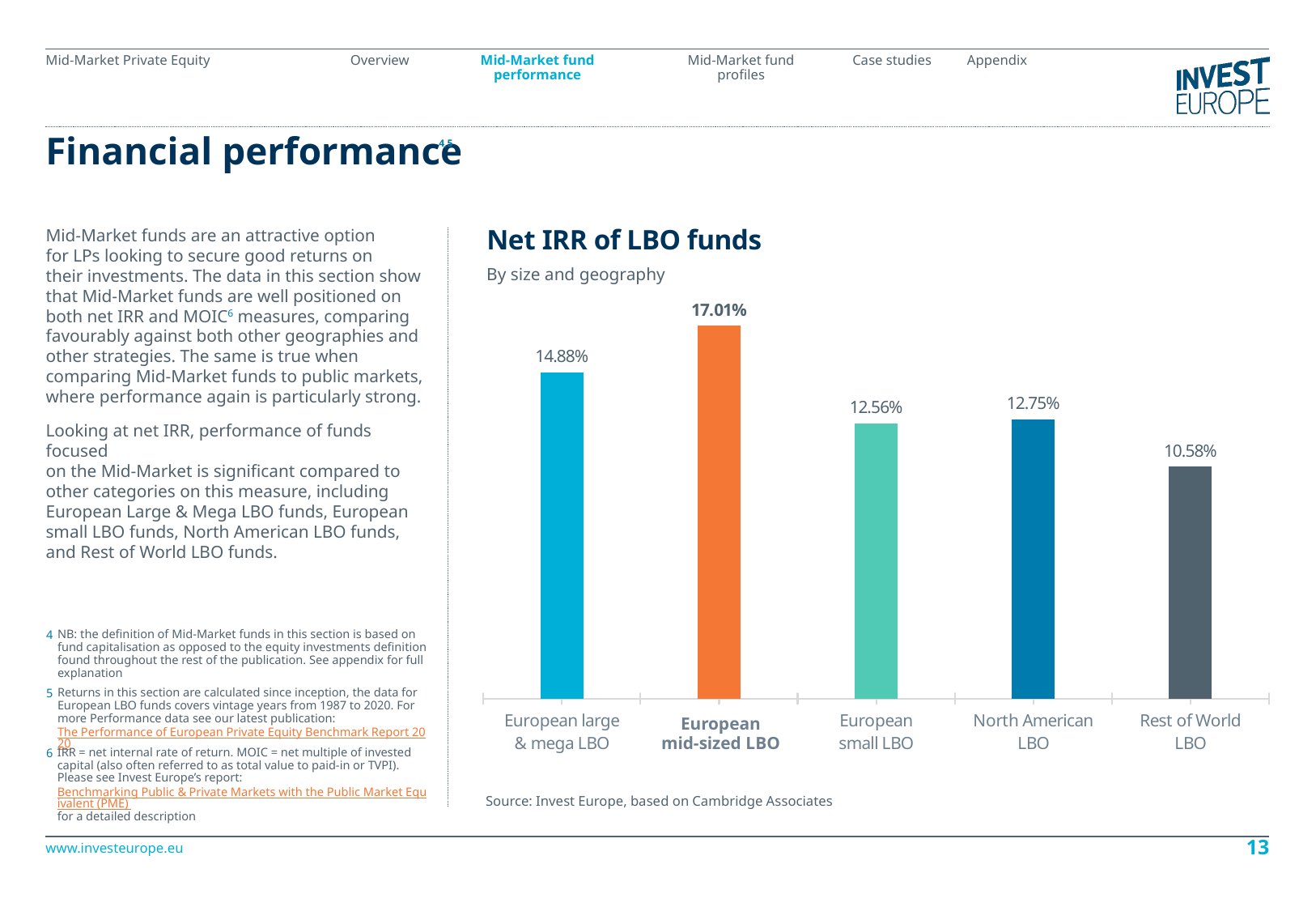
What is the difference in net IRR between European mid-sized LBO and European large & mega LBO funds? 2.13% What is the net IRR for North American LBO funds? 12.75% What colour is the bar for European mid-sized LBO? Orange What is the net IRR for Rest of World LBO funds? 10.58% Which has a higher net IRR, European small LBO or European large & mega LBO? European large & mega LBO Which category has the lowest net IRR? Rest of World LBO What is the subtitle of the chart? By size and geography How many categories are shown in the chart? 5 What type of chart is used to show net IRR of LBO funds? Bar chart What is the net IRR for European mid-sized LBO funds? 17.01% What is the net IRR for European large & mega LBO funds? 14.88% Which category has the highest net IRR? European mid-sized LBO